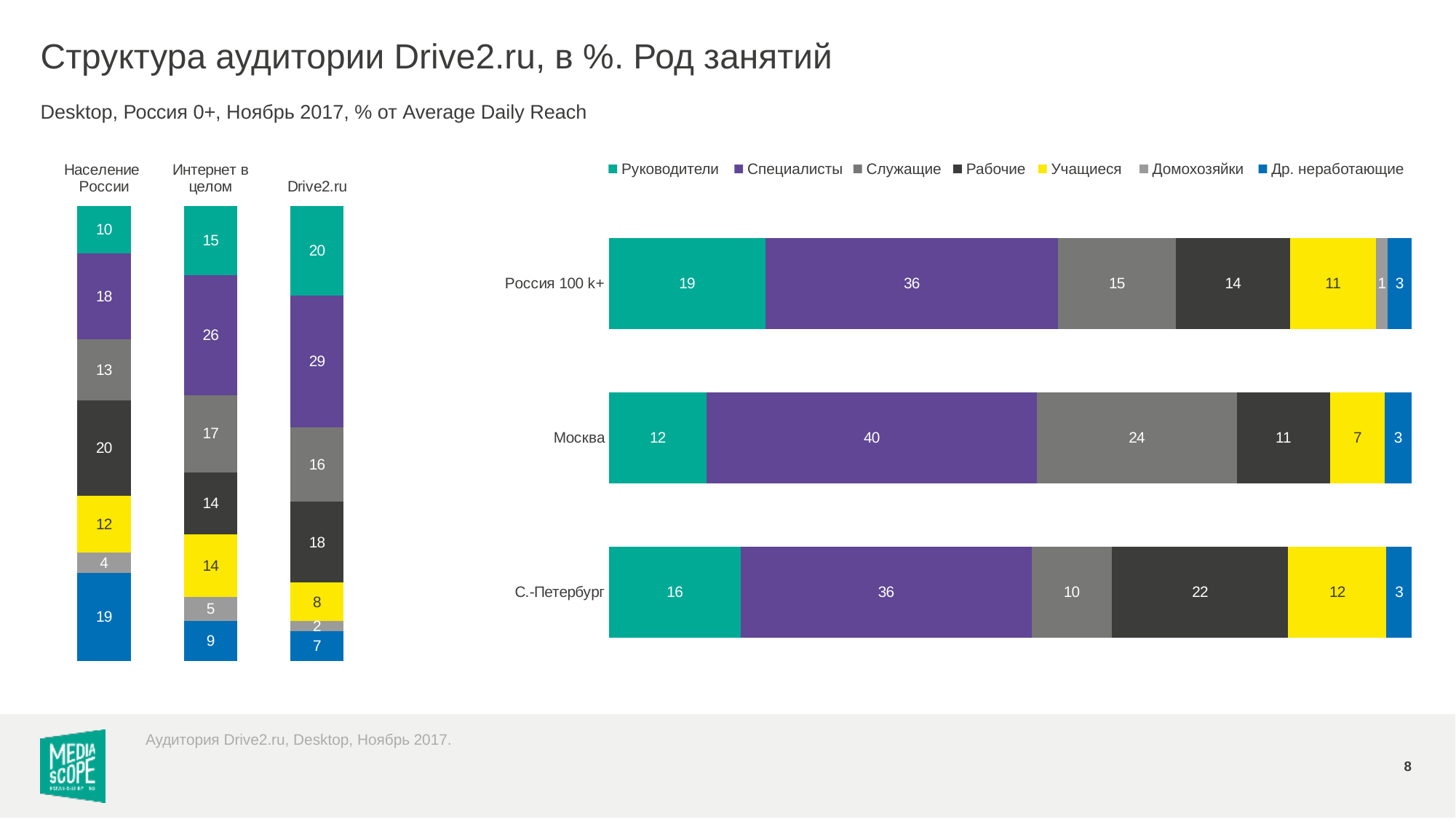
In the left chart, which bar has the highest value for Руководители? Drive2.ru How many bars does the left chart show? 3 In the right chart, which is larger: Рабочие for Москва or Рабочие for С.-Петербург? С.-Петербург In the right chart, which category has the lowest value for Служащие? С.-Петербург What is the total of the Интернет в целом bar in the left chart? 100 In the right chart, what is the value for Рабочие for С.-Петербург? 22 In the left chart, what is the difference between the Специалисты values for Drive2.ru and Население России? 11 In the left chart, what is the value for Др. неработающие in the Население России bar? 19 In the right chart, what is the value for Специалисты for Москва? 40 How many series does the legend list? 7 In the left chart, what is the value for Специалисты in the Drive2.ru bar? 29 What kind of chart is the right chart? Stacked bar chart